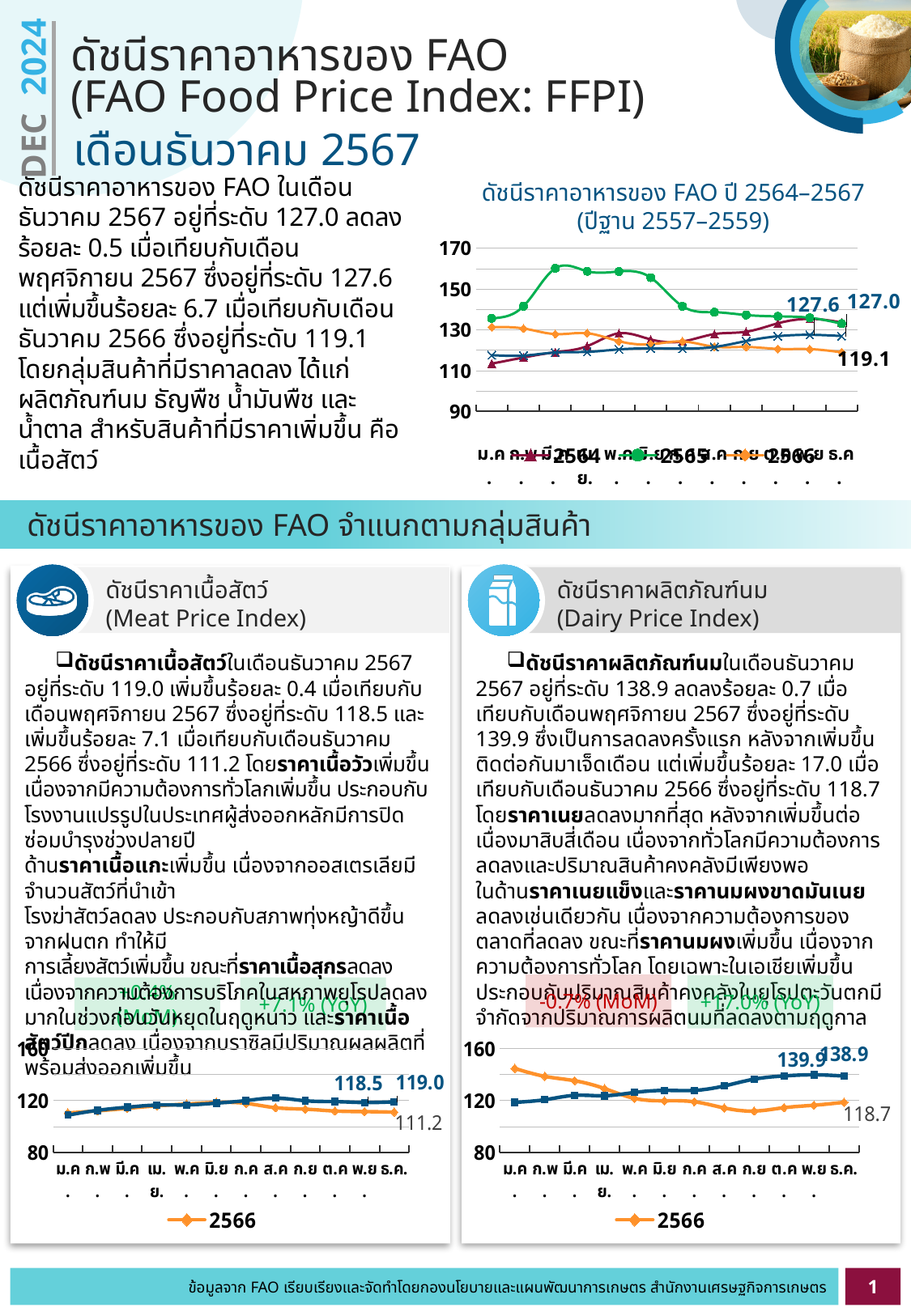
In the top-right FAO Food Price Index chart, what is the labelled value for December 2566? 119.1 In the top-right FAO Food Price Index chart, what is the labelled value for November 2567 (พ.ย.)? 127.6 In the top-right FAO Food Price Index chart, is the peak of the green 2565 line greater or less than 150? greater In the top-right FAO Food Price Index chart, which is larger: the labelled December 2567 value or the labelled December 2566 value? December 2567 (127.0) In the top-right FAO Food Price Index chart, what is the difference between the labelled November 2567 value (127.6) and the December 2567 value (127.0)? 0.6 In the Meat Price Index chart at the bottom left, what is the labelled value for December 2567 (ธ.ค.)? 119.0 In the top-right FAO Food Price Index chart, what is the labelled value for December 2567 (ธ.ค.)? 127.0 What kind of chart is the 'ดัชนีราคาอาหารของ FAO ปี 2564–2567' chart at the top right of the slide? line chart In the Meat Price Index chart at the bottom left, what is the difference between the labelled December 2567 value (119.0) and the labelled December 2566 value (111.2)? 7.8 How many months are shown on the x axis of the Dairy Price Index chart at the bottom right? 12 In the Dairy Price Index chart at the bottom right, does the orange 2566 line rise or fall from January to December? fall In the Dairy Price Index chart at the bottom right, what is the labelled value for November 2567 (พ.ย.)? 139.9